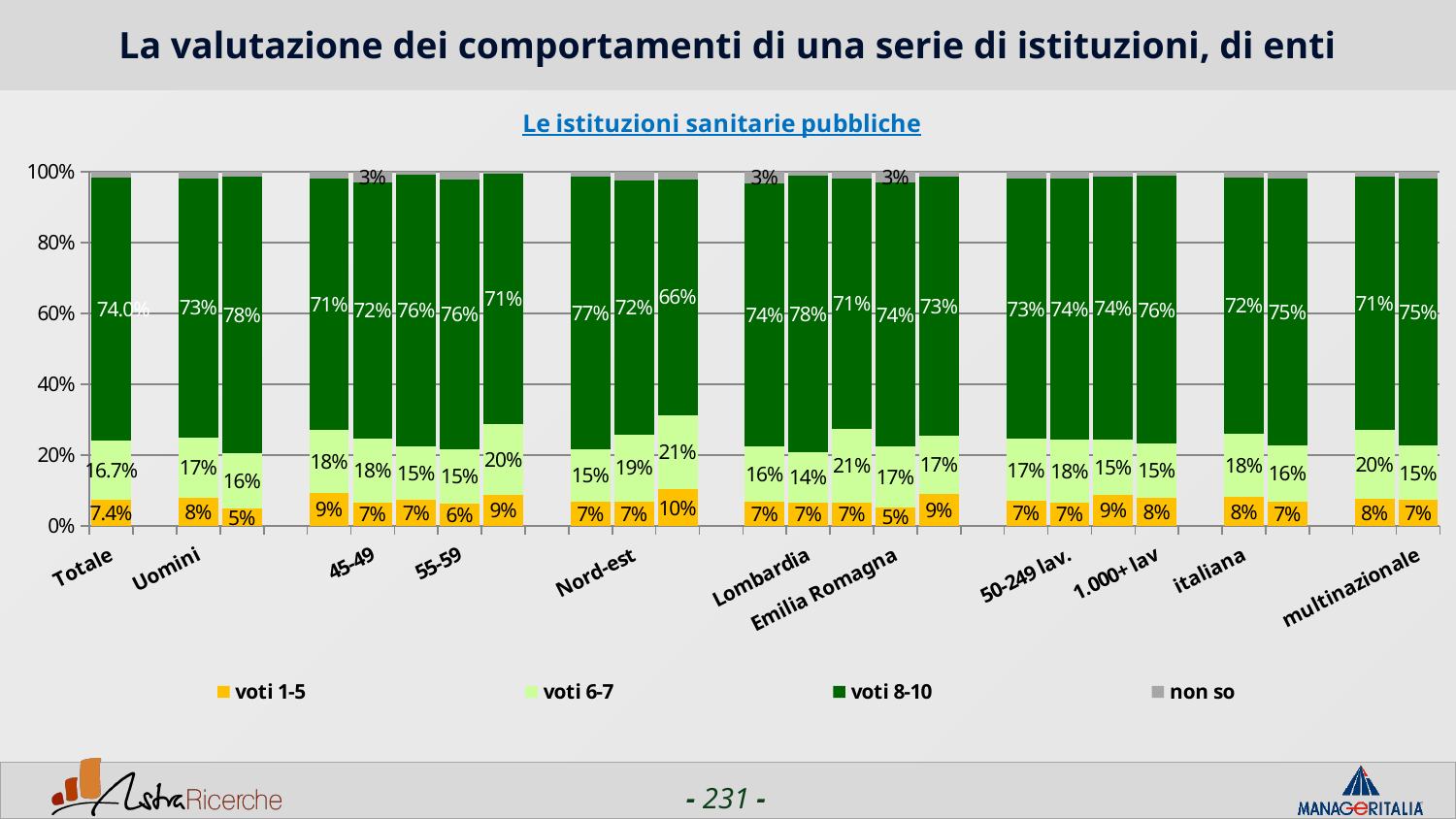
Is the 'voti 8-10' value for Totale greater or less than 60%? greater Which is larger, the 'voti 8-10' value for Lombardia or for Emilia Romagna? Lombardia What kind of chart is shown on the slide? bar chart What is the value of 'voti 6-7' for Totale? 16.7% What is the value of 'voti 8-10' for Lombardia? 78% How many series does the legend list? 4 What is the value of 'voti 1-5' for Uomini? 8% What is the subtitle of the chart? Le istituzioni sanitarie pubbliche What is the value of 'voti 8-10' for Totale? 74.0% What is the difference between the 'voti 8-10' values for Lombardia (78%) and Emilia Romagna (74%)? 4 percentage points What is the value of 'voti 8-10' for Uomini? 73% What is the value of 'voti 1-5' for Totale? 7.4%